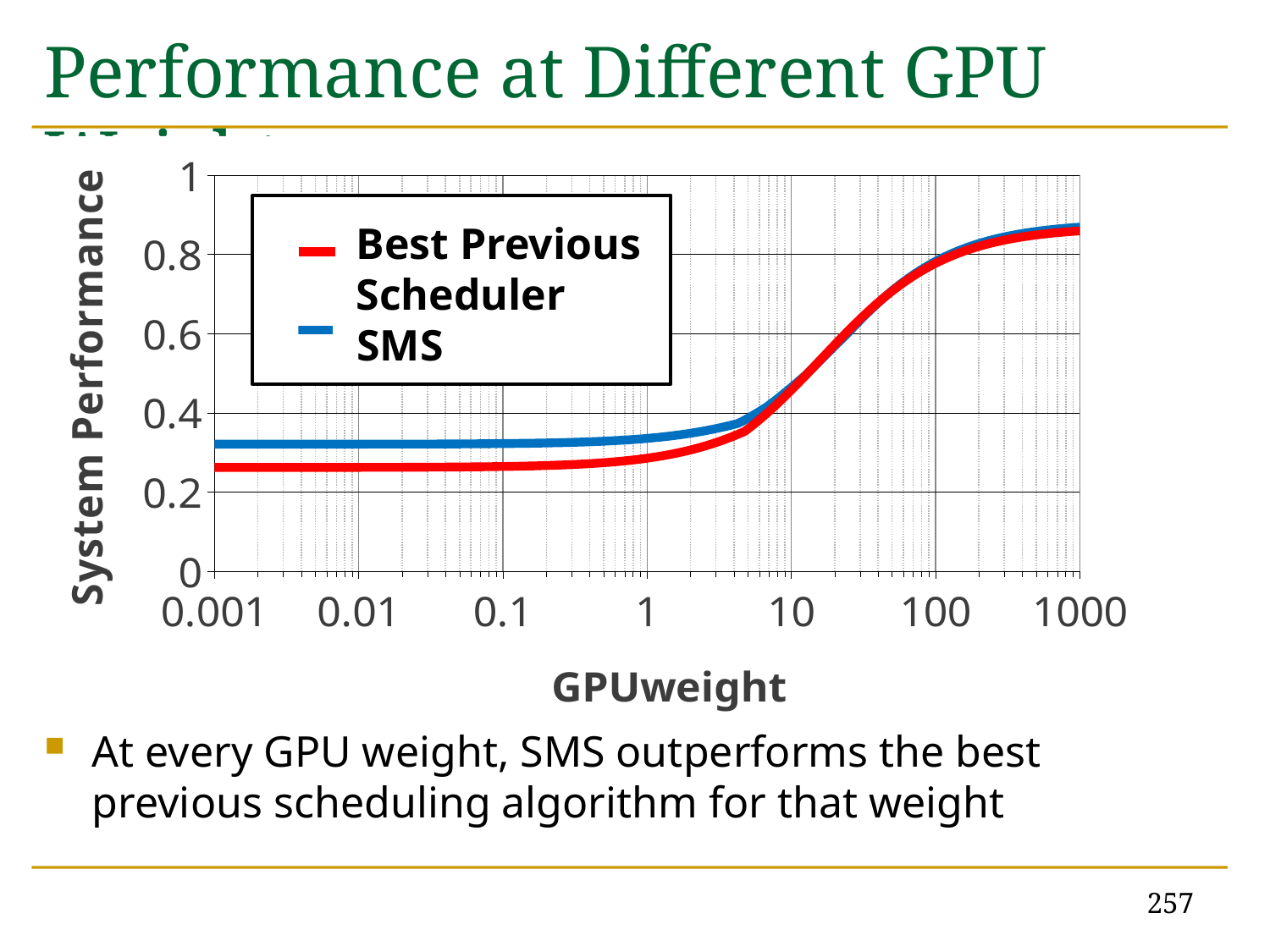
Is the System Performance for SMS at GPUweight 1000 greater or less than 0.8? greater Is the System Performance for SMS at GPUweight 0.001 greater or less than 0.2? greater Is the System Performance for Best Previous Scheduler at GPUweight 1000 greater or less than 0.6? greater What kind of chart is shown on the slide? line chart Does System Performance rise or fall as GPUweight increases from 1 to 1000? rise At GPUweight 0.001, which series has the higher System Performance, SMS or Best Previous Scheduler? SMS What is the label of the x axis? GPUweight How many series does the legend list? 2 What is the label of the y axis? System Performance